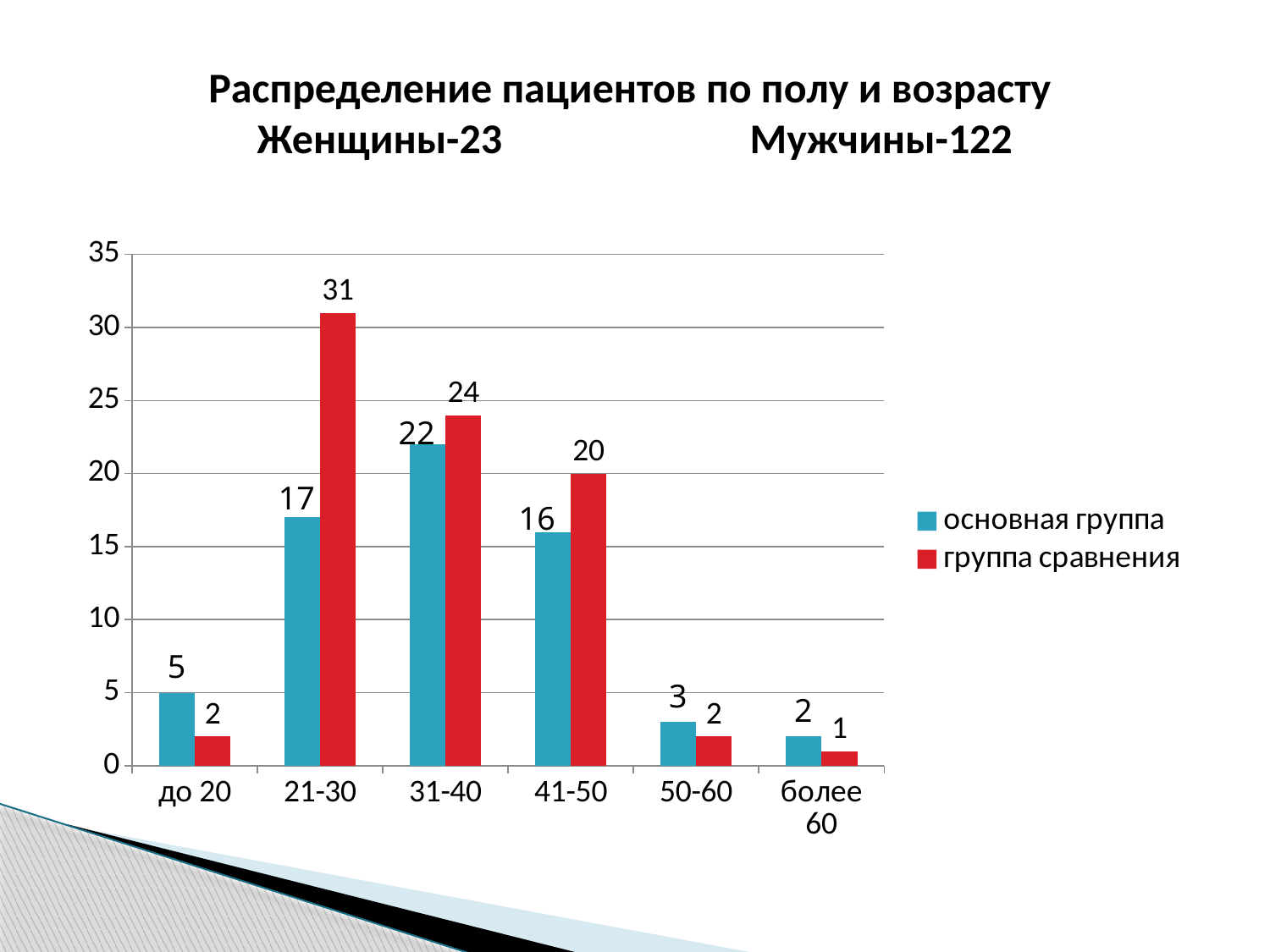
Which category has the lowest value for the основная группа series? более 60 Which category has the highest value for the группа сравнения series? 21-30 What colour are the bars for the группа сравнения series? red What is the value for the основная группа series in the более 60 category? 2 What is the difference between the группа сравнения and основная группа values in the 21-30 category? 14 What is the value for the основная группа series in the 21-30 category? 17 What kind of chart is shown on the slide? bar chart How many age categories are shown on the x axis? 6 Is the value for группа сравнения in the 21-30 category greater or less than 30? greater What is the value for the группа сравнения series in the 31-40 category? 24 How many series does the legend list? 2 In the 41-50 category, which series has the larger value, основная группа or группа сравнения? группа сравнения